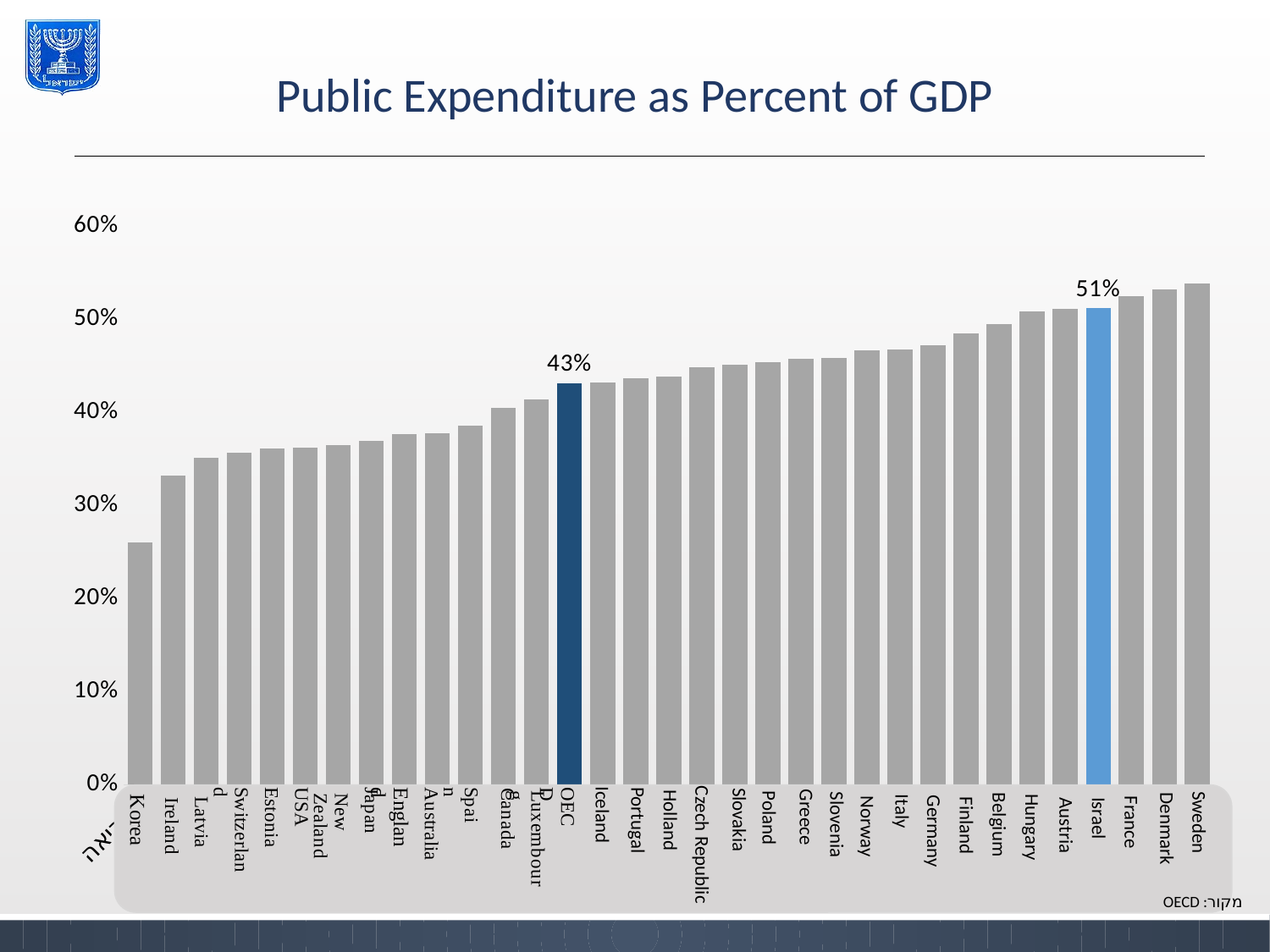
What is the value shown for Israel? 51% Is the value for Korea greater or less than 30%? less Which is larger, the value for Israel or the value for OECD? Israel Is the value for Germany greater or less than 40%? greater What kind of chart is shown on the slide? Bar chart Is the value for Sweden greater or less than 50%? greater What is the value shown for OECD? 43% Do the values rise or fall moving from left to right along the x axis? Rise Which country has the highest public expenditure as percent of GDP? Sweden Which country has the lowest public expenditure as percent of GDP? Korea By how many percentage points does Israel's value exceed the OECD value? 8 percentage points What is the title of the chart? Public Expenditure as Percent of GDP